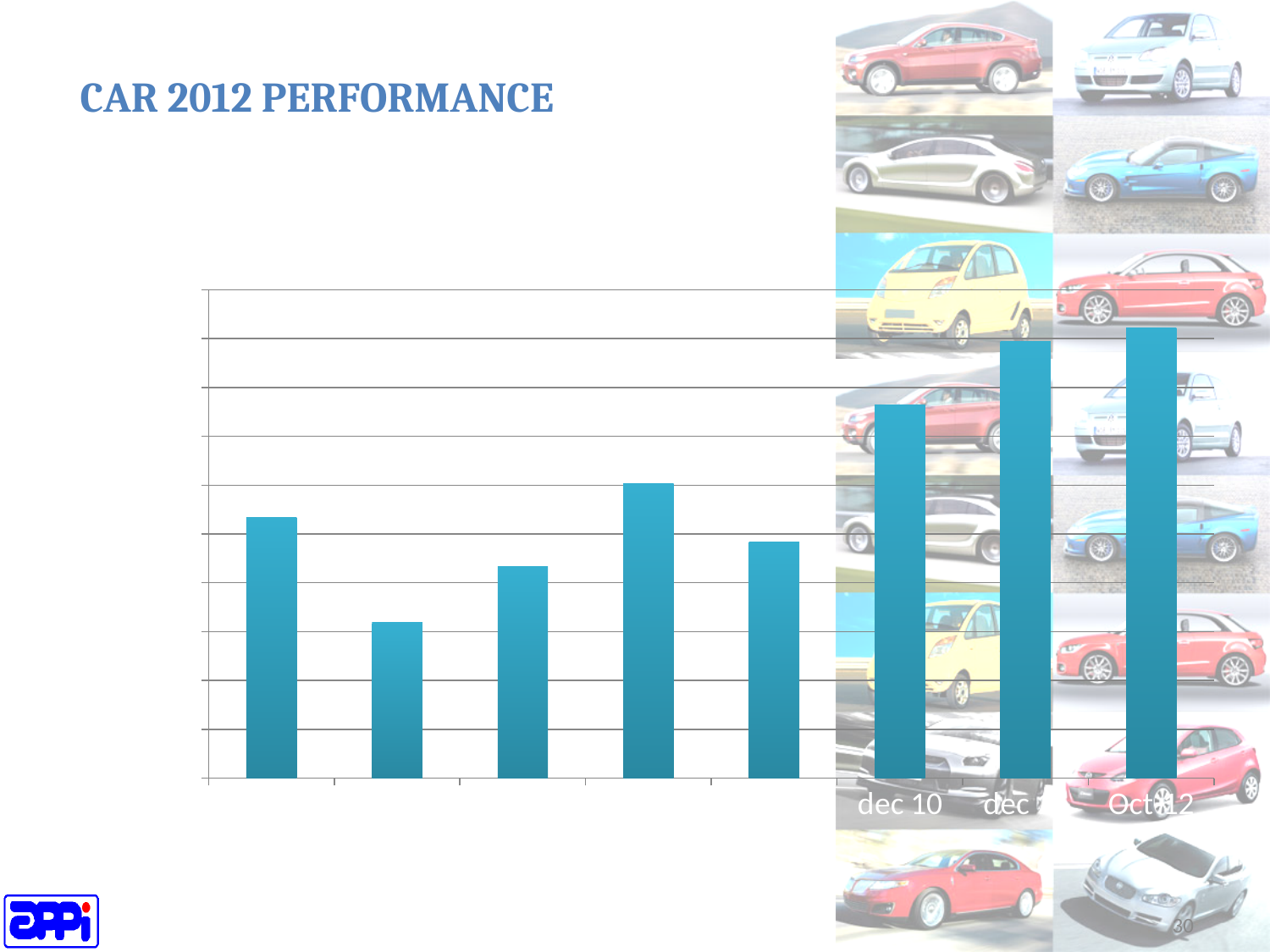
What is the title of the slide containing the chart? CAR 2012 PERFORMANCE Is the bar for Oct 12 taller or shorter than the bar for dec 10? taller How many bars are plotted in the chart? 8 What kind of chart is shown on the slide? bar chart What colour are the bars in the chart? teal blue Which is larger, the value for dec 10 or the value for Oct 12? Oct 12 Do the values rise or fall across the last three bars of the chart, ending at Oct 12? rise Which category has the highest bar in the chart? Oct 12